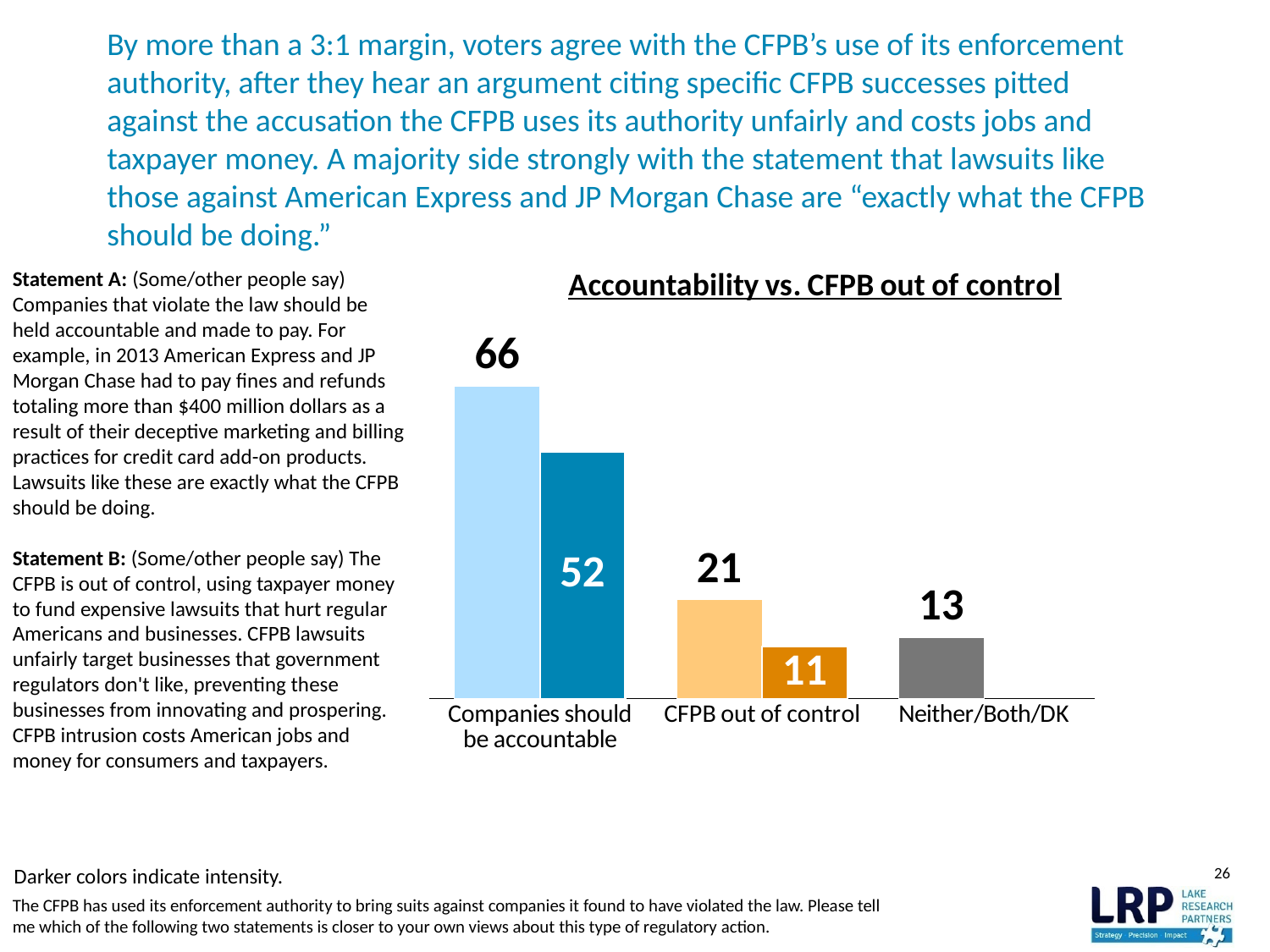
What is the title of the chart? Accountability vs. CFPB out of control Which category has the highest total value? Companies should be accountable What is the value of the darker (intensity) bar for 'CFPB out of control'? 11 What is the total value shown for 'Companies should be accountable'? 66 What is the total value shown for 'CFPB out of control'? 21 Which category has the lowest total value? Neither/Both/DK What is the value of the darker (intensity) bar for 'Companies should be accountable'? 52 How many categories are shown on the x axis of the chart? 3 What is the difference between the total for 'Companies should be accountable' and the total for 'CFPB out of control'? 45 What kind of chart is shown on the slide? Bar chart What is the value shown for 'Neither/Both/DK'? 13 Which is larger: the darker bar for 'Companies should be accountable' or the total bar for 'CFPB out of control'? The darker bar for Companies should be accountable